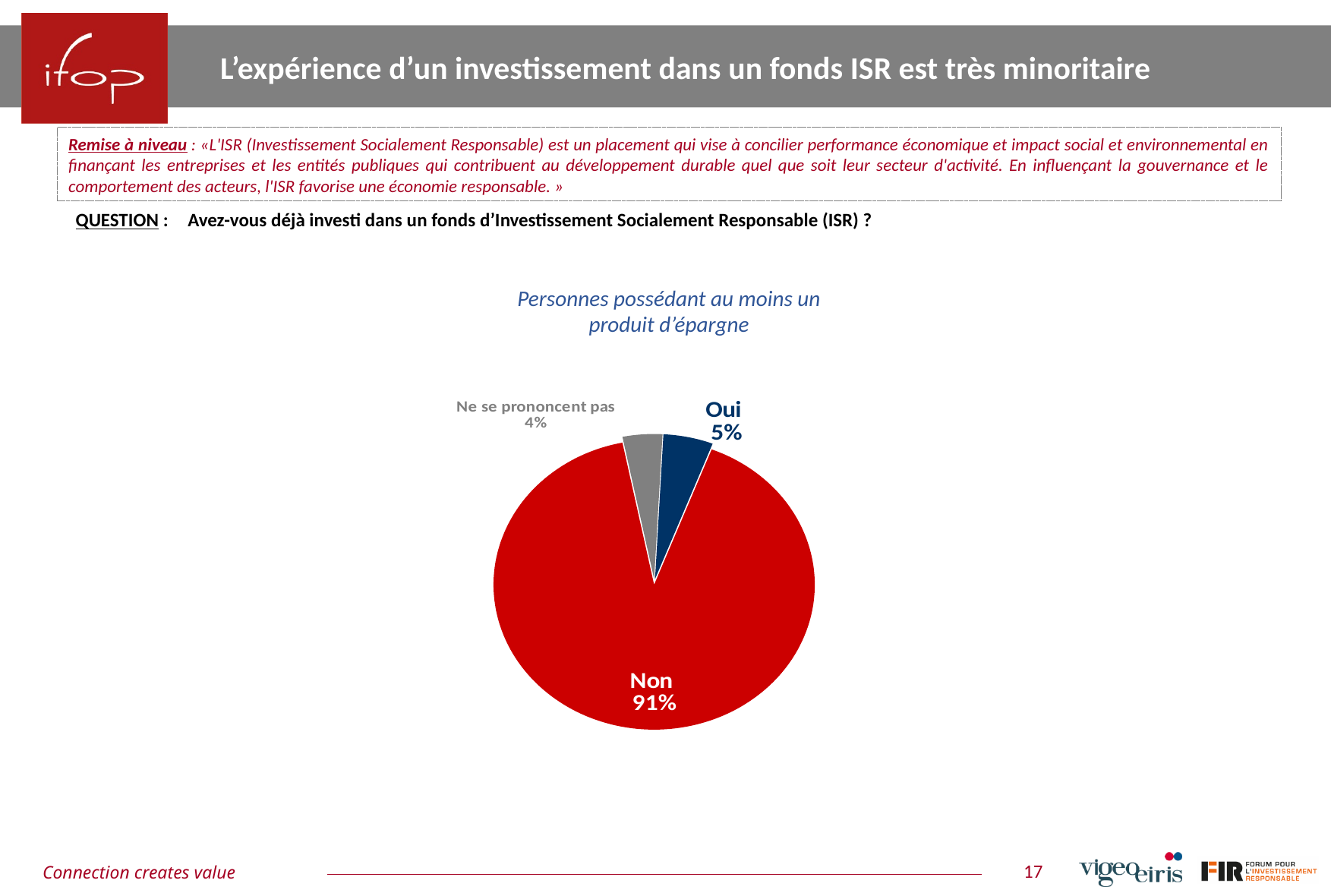
Which is larger, the share for "Oui" or the share for "Ne se prononcent pas"? Oui What population does the chart subtitle say the pie chart covers? Personnes possédant au moins un produit d'épargne What is the combined share of "Oui" and "Ne se prononcent pas"? 9% Which category has the largest share of the pie? Non What percentage of respondents answered "Oui"? 5% What kind of chart is shown on the slide? Pie chart What colour is the "Non" slice of the pie? Red Which category has the smallest share of the pie? Ne se prononcent pas What percentage of respondents are in the "Ne se prononcent pas" category? 4% What percentage of respondents answered "Non"? 91% What is the difference in percentage points between "Non" and "Oui"? 86 How many slices does the pie chart have? 3